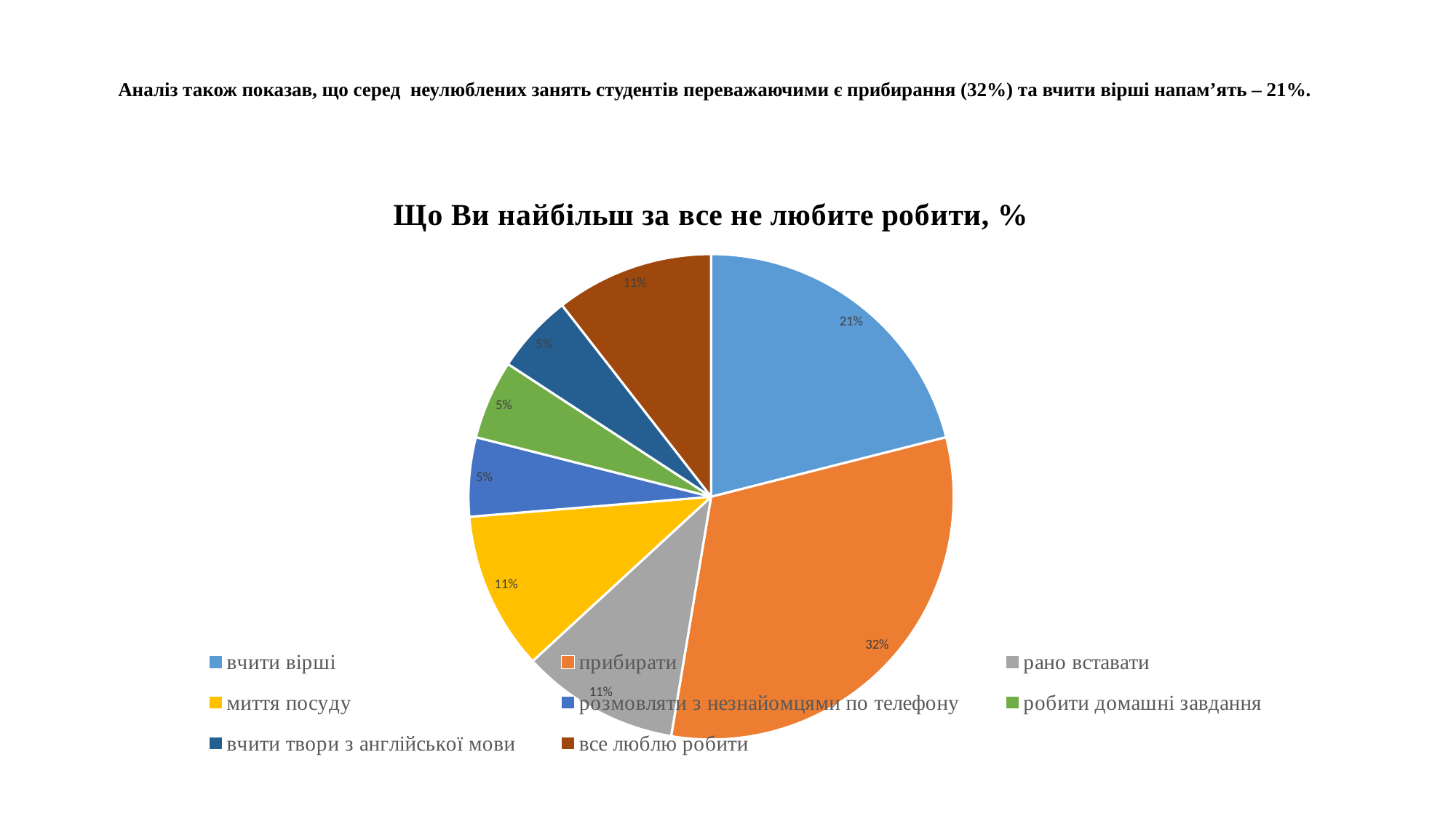
What is the difference between the shares for "прибирати" and "вчити вірші"? 11% What is the title of the chart? Що Ви найбільш за все не любите робити, % What kind of chart is shown on the slide? pie chart Which category has the largest slice of the pie? прибирати Which is larger, the share for "рано вставати" or the share for "вчити твори з англійської мови"? рано вставати What share of the pie does "миття посуду" take? 11% What share of the pie does "робити домашні завдання" take? 5% How many categories does the legend list? 8 What colour is the slice for "прибирати"? orange What share of the pie does "прибирати" take? 32%